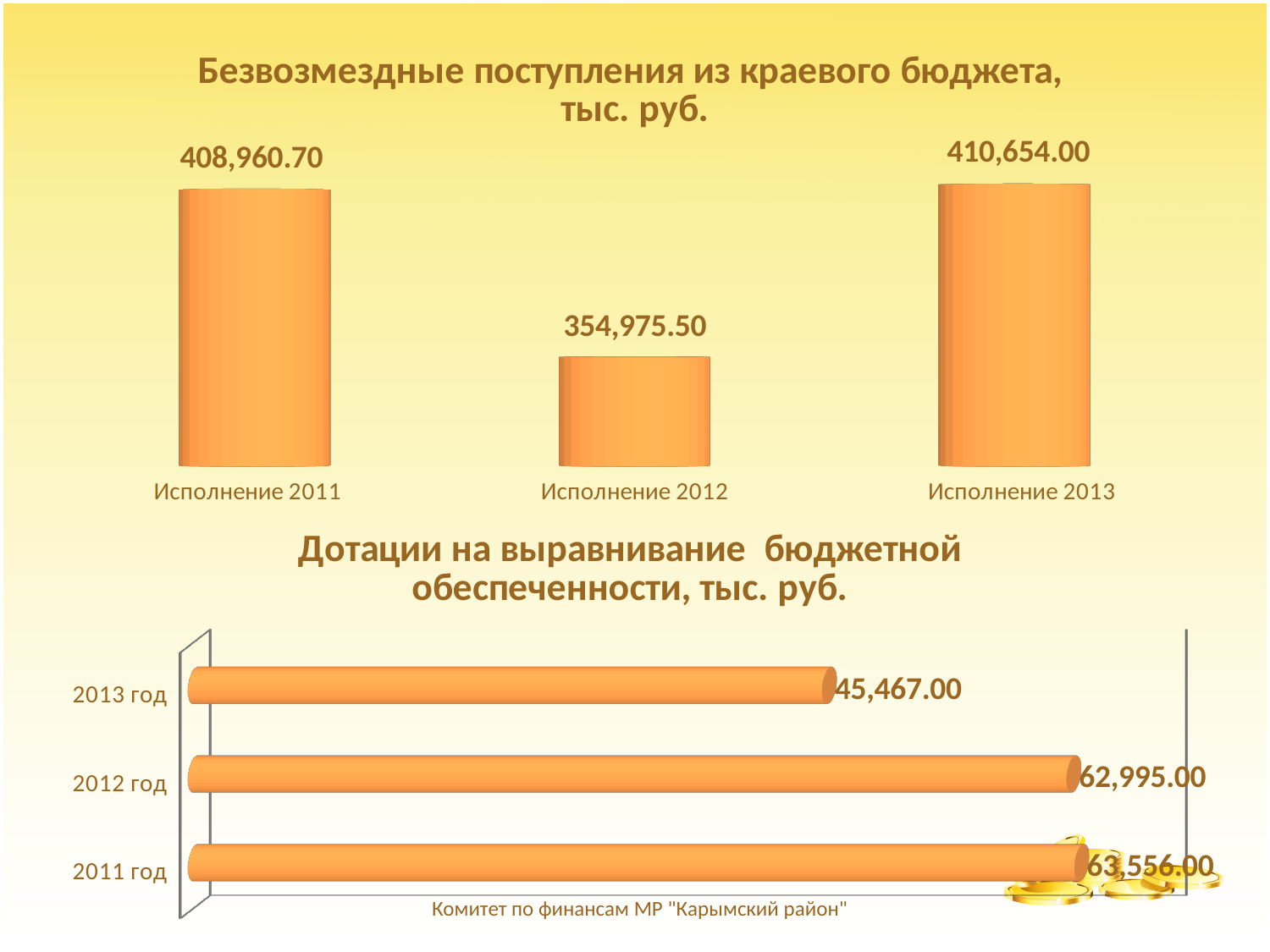
In the top chart 'Безвозмездные поступления из краевого бюджета', what is the difference between Исполнение 2011 and Исполнение 2012? 53,985.20 In the top chart 'Безвозмездные поступления из краевого бюджета', what is the value for Исполнение 2013? 410,654.00 In the bottom chart 'Дотации на выравнивание бюджетной обеспеченности', what is the value for 2013 год? 45,467.00 In the bottom chart 'Дотации на выравнивание бюджетной обеспеченности', what is the difference between 2012 год and 2013 год? 17,528.00 What type of chart is the bottom chart 'Дотации на выравнивание бюджетной обеспеченности'? Bar chart In the top chart 'Безвозмездные поступления из краевого бюджета', what is the value for Исполнение 2012? 354,975.50 In the top chart 'Безвозмездные поступления из краевого бюджета', which category has the highest value? Исполнение 2013 In the top chart 'Безвозмездные поступления из краевого бюджета', which category has the lowest value? Исполнение 2012 In the bottom chart 'Дотации на выравнивание бюджетной обеспеченности', what is the value for 2011 год? 63,556.00 In the bottom chart 'Дотации на выравнивание бюджетной обеспеченности', which is larger, the value for 2011 год or 2012 год? 2011 год In the bottom chart 'Дотации на выравнивание бюджетной обеспеченности', which year has the lowest value? 2013 год In the top chart 'Безвозмездные поступления из краевого бюджета', how many categories are shown? 3